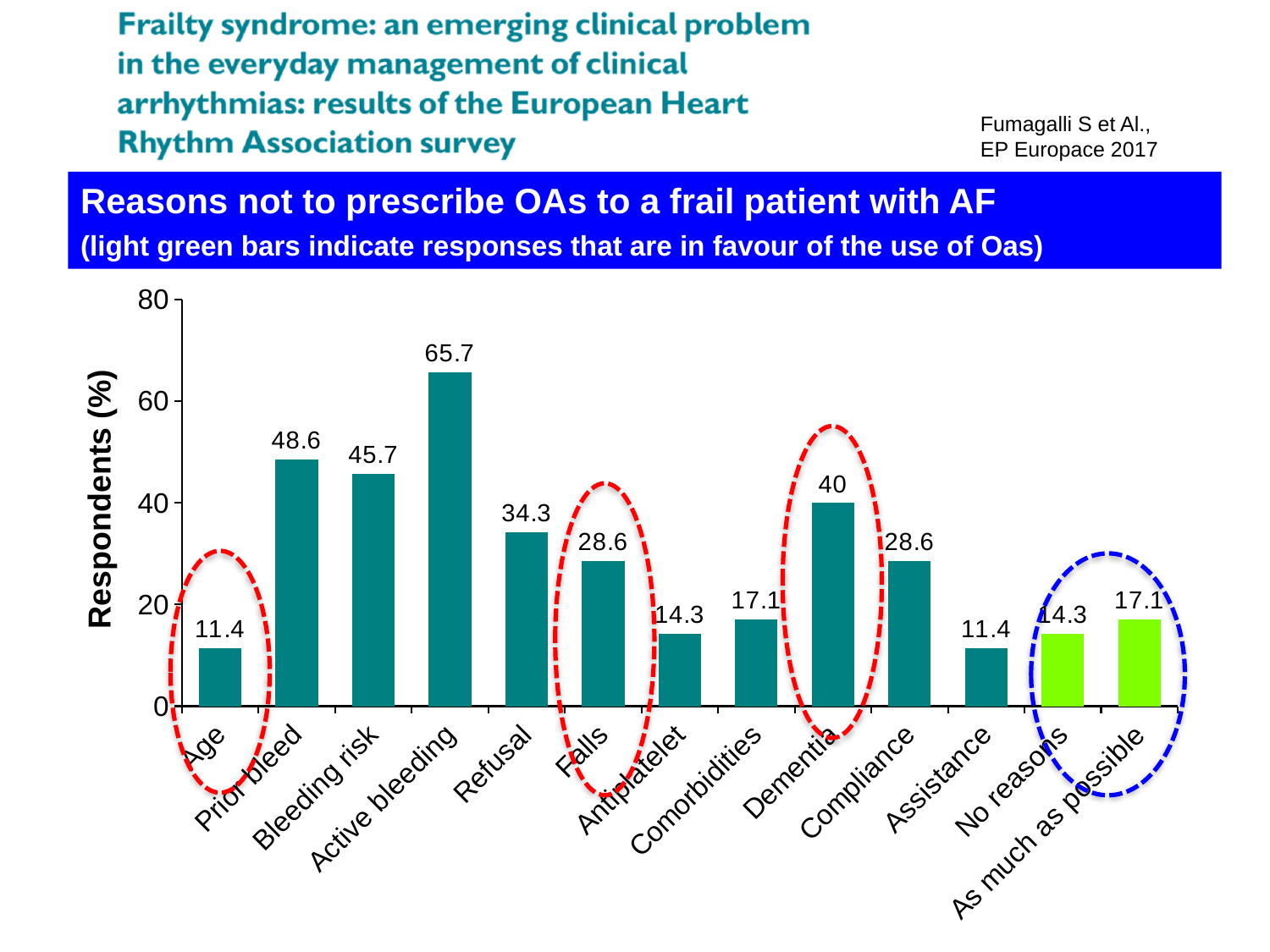
What is the value for Dementia? 40 Which is larger, the value for Refusal or the value for Falls? Refusal How many categories are shown on the x axis? 13 Which category has the highest percentage of respondents? Active bleeding What is the difference between the values for Dementia and Compliance? 11.4 What percentage of respondents cited Active bleeding as a reason not to prescribe OAs? 65.7 What is the label of the y axis? Respondents (%) What is the value for Prior bleed? 48.6 Which two categories are shown with light green bars? No reasons and As much as possible What kind of chart is shown on the slide? bar chart Is the value for Bleeding risk greater or less than 40? greater What is the difference between the values for Active bleeding and Prior bleed? 17.1